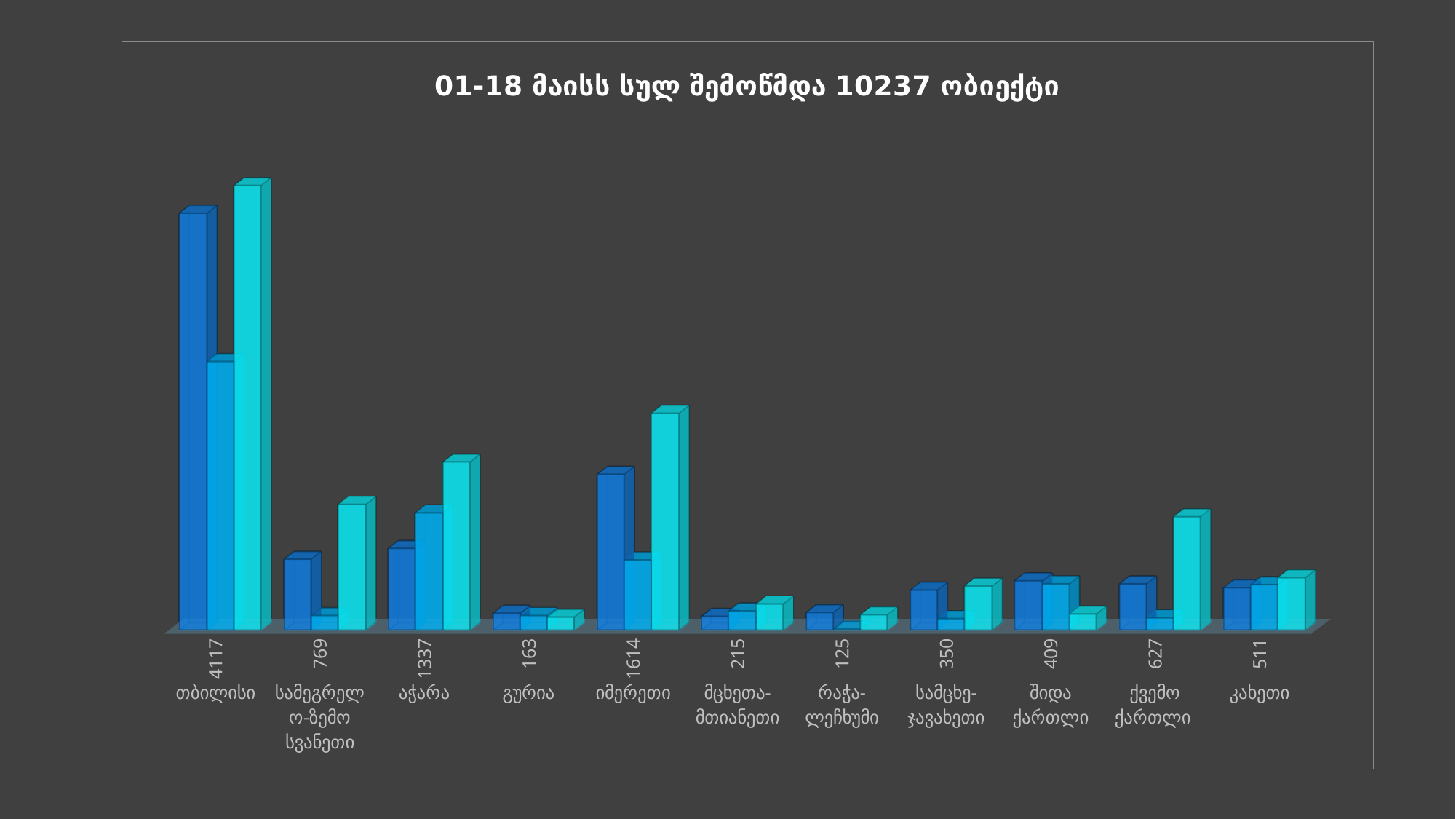
How many bars are plotted for each category? 3 What value is printed below the რაჭა-ლეჩხუმი category? 125 What is the difference between the printed values for თბილისი and იმერეთი? 2503 What value is printed below the იმერეთი category? 1614 What kind of chart is shown on the slide? bar chart Which has the larger printed value, სამეგრელო-ზემო სვანეთი or ქვემო ქართლი? სამეგრელო-ზემო სვანეთი Which category has the highest printed value? თბილისი Which category has the lowest printed value? რაჭა-ლეჩხუმი How many categories are shown along the x axis of the chart? 11 What value is printed below the თბილისი category? 4117 What is the title of the chart? 01-18 მაისს სულ შემოწმდა 10237 ობიექტი What value is printed below the აჭარა category? 1337